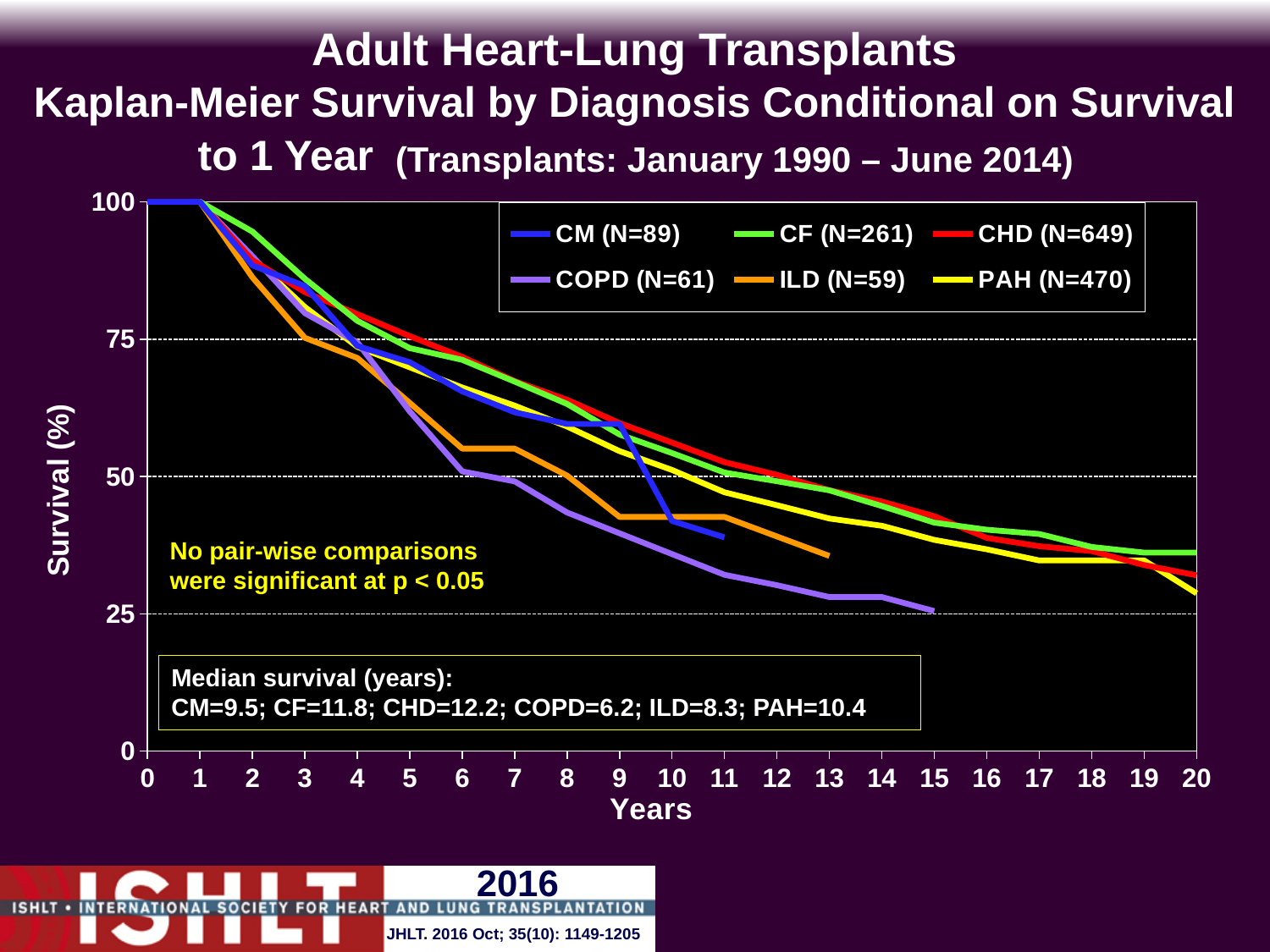
Is the survival value for ILD at 13 years greater or less than 25? greater How many series does the legend list? 6 What is the median survival in years for CHD? 12.2 What is the median survival in years for COPD? 6.2 What is the difference in median survival (years) between CHD and COPD? 6.0 Which diagnosis group has the largest N in the legend? CHD (N=649) Which diagnosis has the lowest median survival? COPD Which diagnosis has the highest median survival? CHD What kind of chart is shown on the slide? line chart Do the survival curves rise or fall as years increase? fall Which has the larger median survival, CF or PAH? CF Is the survival value for COPD at 10 years greater or less than 50? less